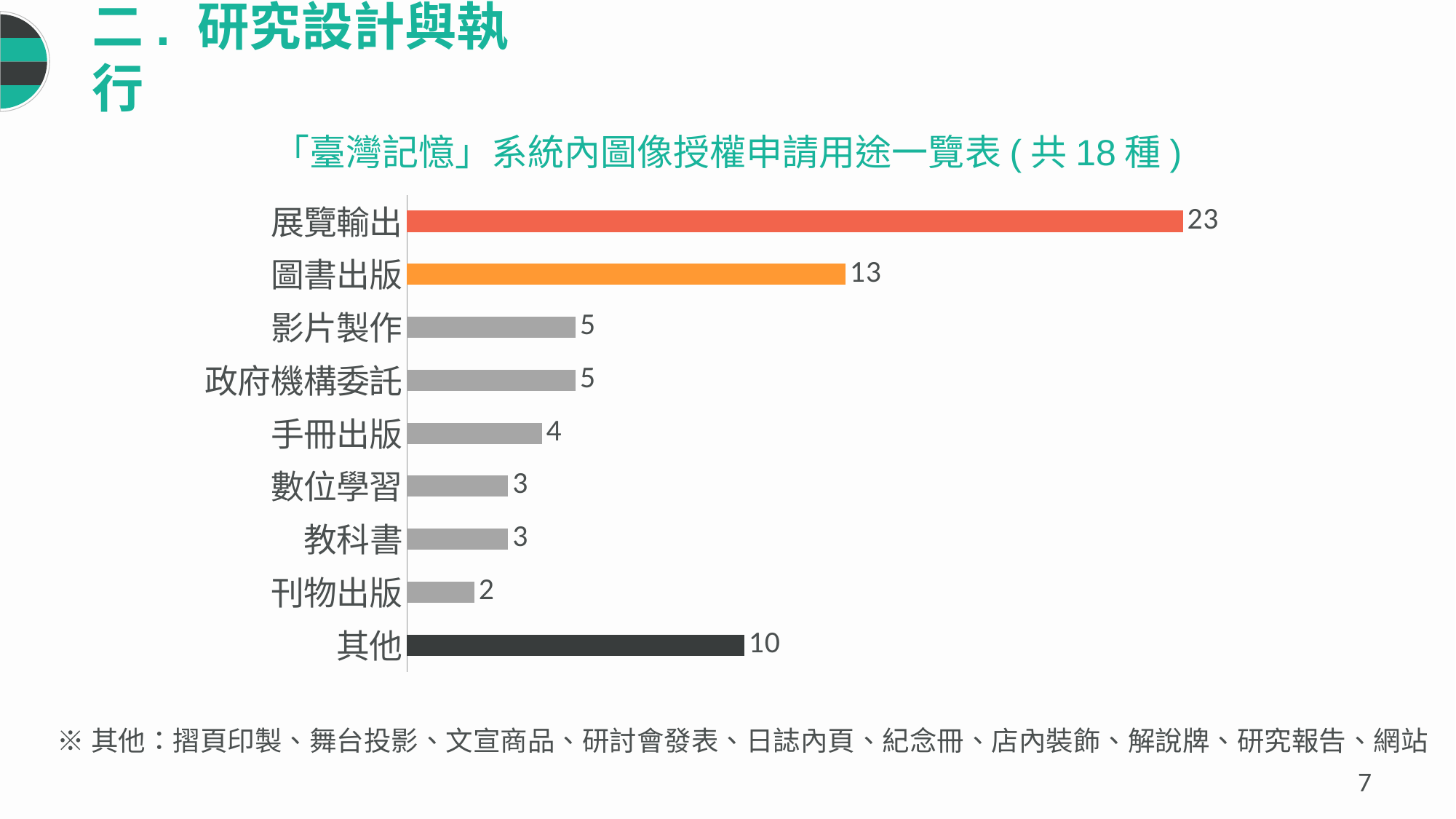
Which is larger, the value for 其他 or the value for 影片製作? 其他 What is the value for 其他? 10 Which category has the lowest value? 刊物出版 Which category has the highest value? 展覽輸出 What is the value for 展覽輸出? 23 How many categories are shown in the chart? 9 What colour is the bar for 圖書出版? orange What is the difference between the values for 展覽輸出 and 圖書出版? 10 What kind of chart is shown on the slide? bar chart What is the title of the chart? 「臺灣記憶」系統內圖像授權申請用途一覽表 ( 共 18 種 ) What is the value for 刊物出版? 2 What is the value for 圖書出版? 13